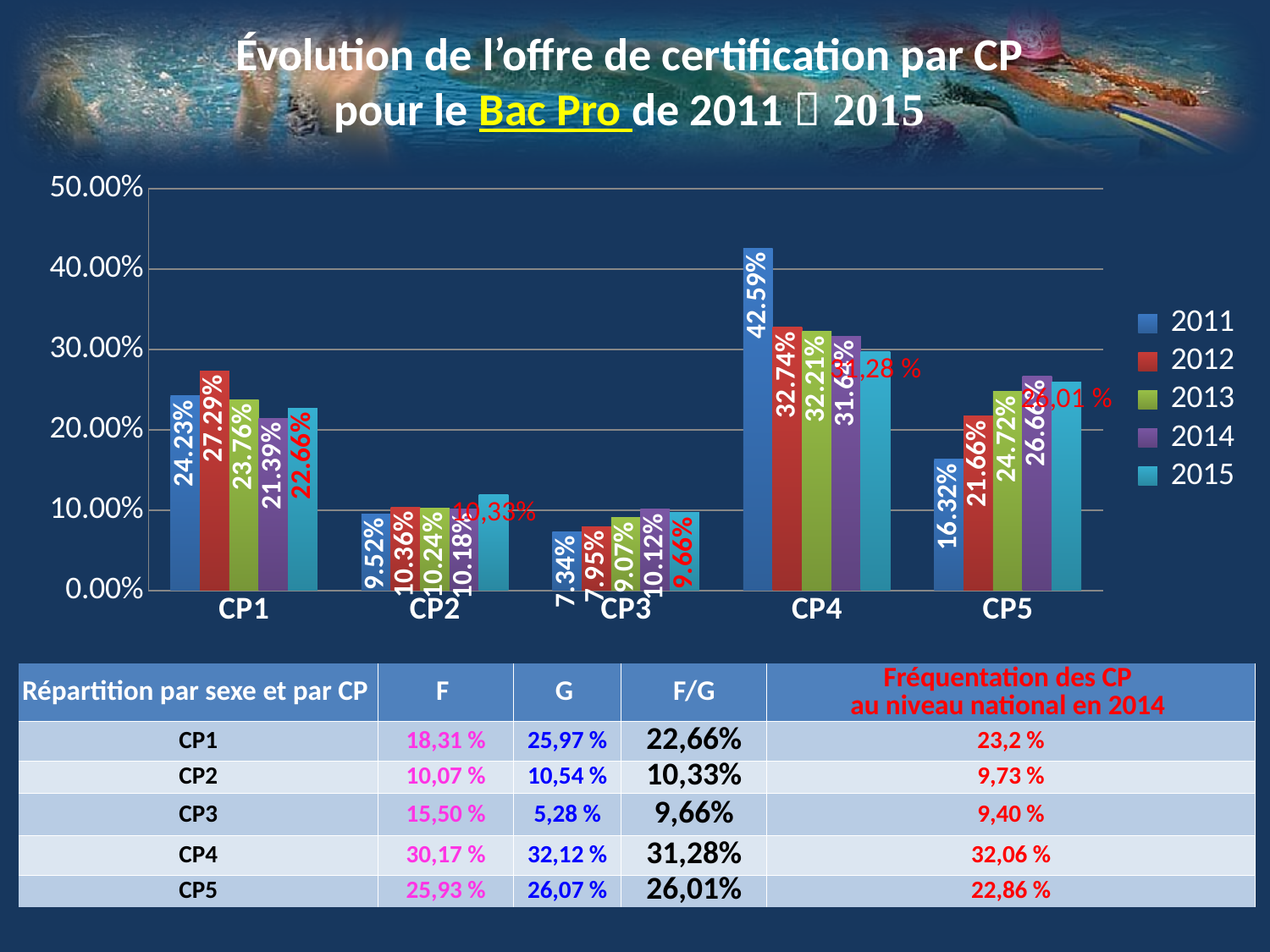
How many series does the legend list? 5 Which CP has the lowest value in 2011? CP3 What is the value for CP1 in 2012? 27.29% What is the value for CP5 in 2011? 16.32% What is the value for CP4 in 2011? 42.59% What is the difference between the 2011 and 2012 values for CP4? 9.85 percentage points For CP1, which year has the larger value, 2011 or 2012? 2012 How many CP categories are shown on the x axis? 5 Do the values for CP4 rise or fall from 2011 to 2015? fall Which CP has the highest value in 2011? CP4 Is the value for CP4 in 2011 greater or less than 40%? greater What is the value for CP3 in 2014? 10.12%